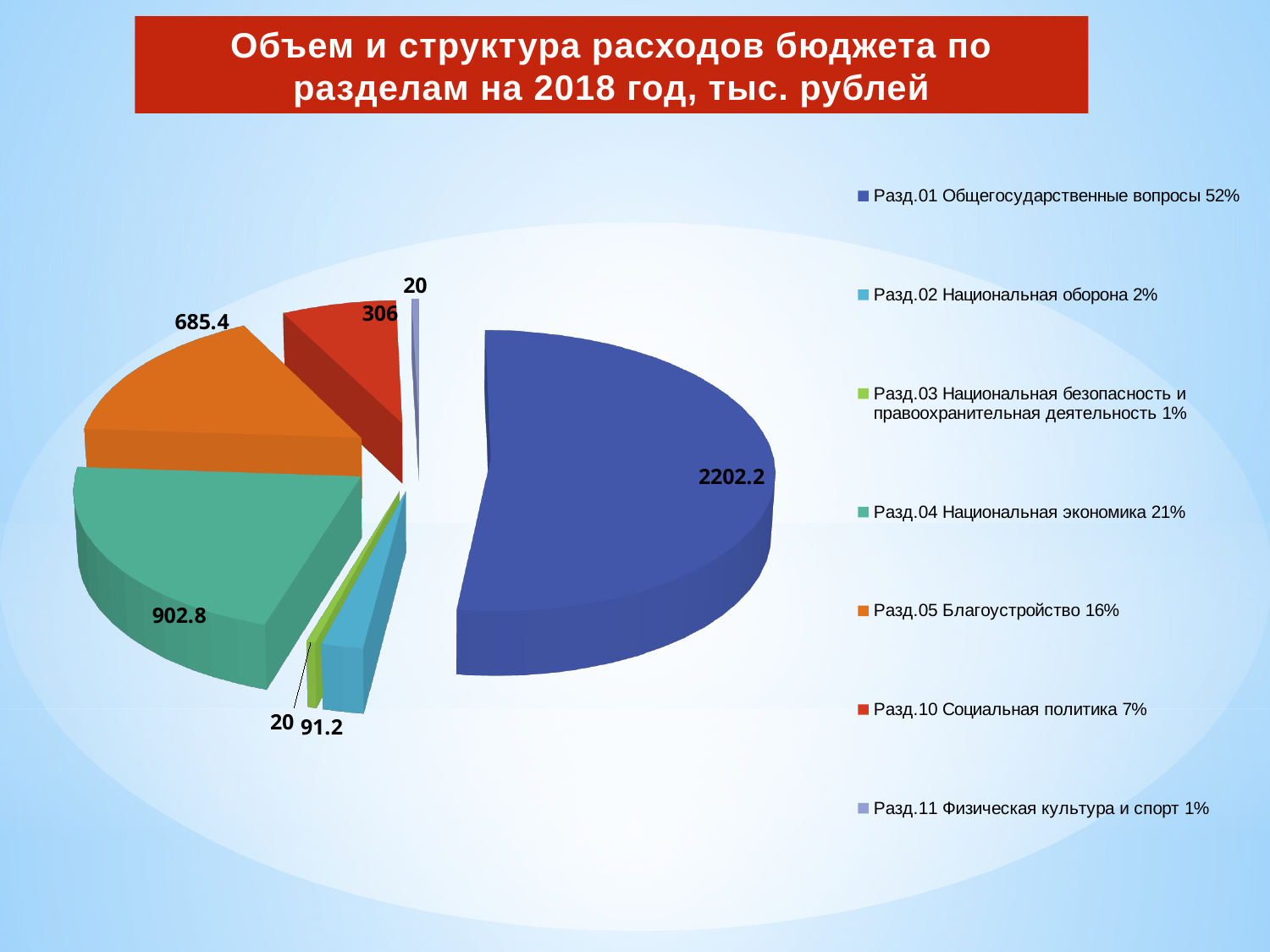
What share of the pie does Разд.04 Национальная экономика represent, according to the legend? 21% How many sections does the legend list? 7 What kind of chart is shown on the slide? pie chart What is the value for Разд.05 Благоустройство? 685.4 What is the value for Разд.02 Национальная оборона? 91.2 What is the value for Разд.01 Общегосударственные вопросы? 2202.2 Which is larger, the value for Разд.05 Благоустройство or Разд.10 Социальная политика? Разд.05 Благоустройство Which section has the largest share of the pie? Разд.01 Общегосударственные вопросы What is the difference between the values for Разд.04 Национальная экономика and Разд.05 Благоустройство? 217.4 What is the value for Разд.10 Социальная политика? 306 What is the title of the chart? Объем и структура расходов бюджета по разделам на 2018 год, тыс. рублей What is the value for Разд.04 Национальная экономика? 902.8